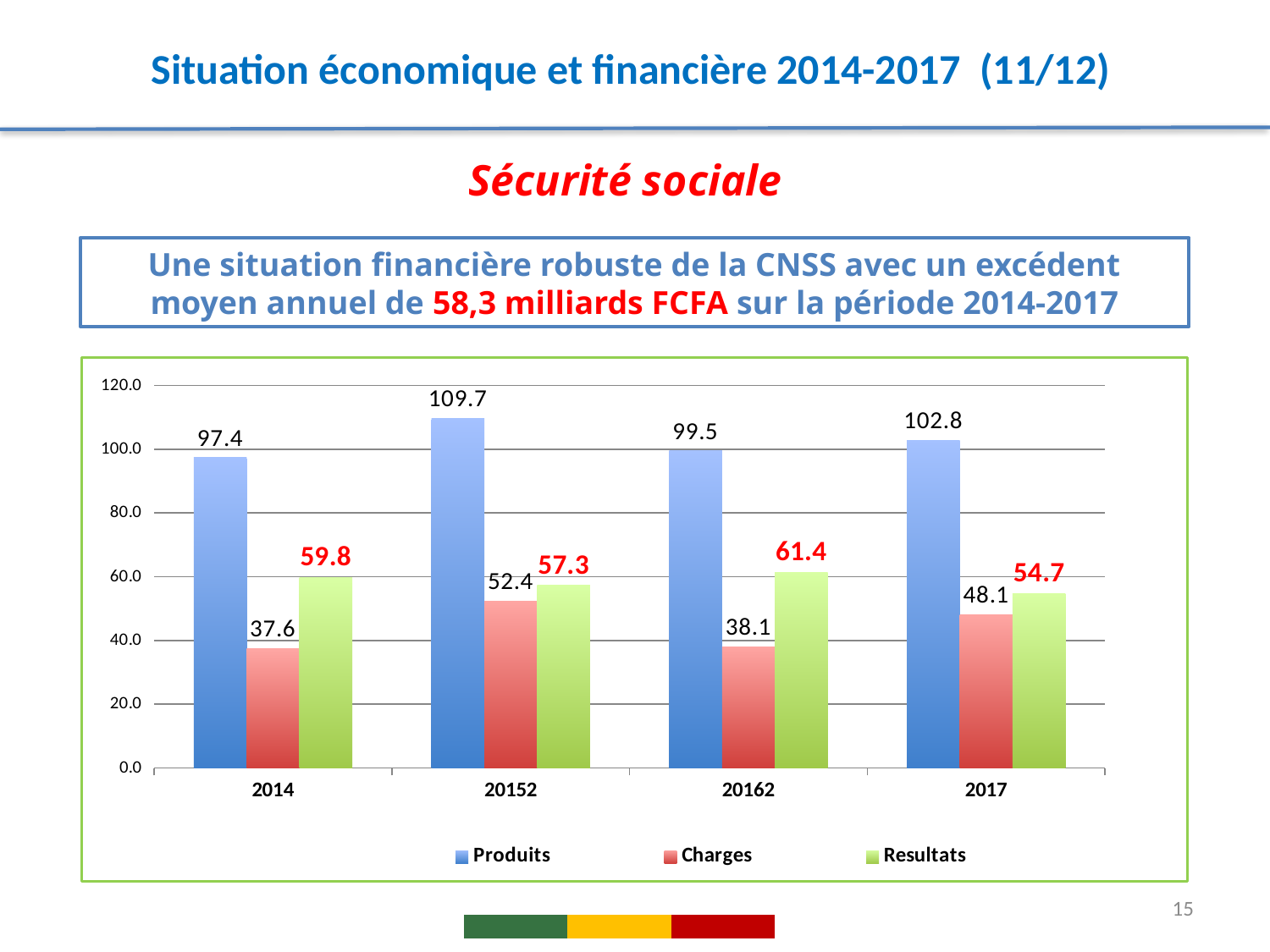
Which is larger, Charges for 20152 or Charges for 2017? Charges for 20152 How many series does the legend list? 3 What is the value of Charges for 2017? 48.1 How many categories are shown on the x axis? 4 What is the value of Resultats for the category labelled 20162? 61.4 What is the value of Produits for 2014? 97.4 Which category has the highest Produits value? 20152 What is the difference between Produits and Charges for 2014? 59.8 Which category has the lowest Resultats value? 2017 Which series is shown in green in the legend? Resultats Which category has the lowest Charges value? 2014 What kind of chart is shown on the slide? Bar chart